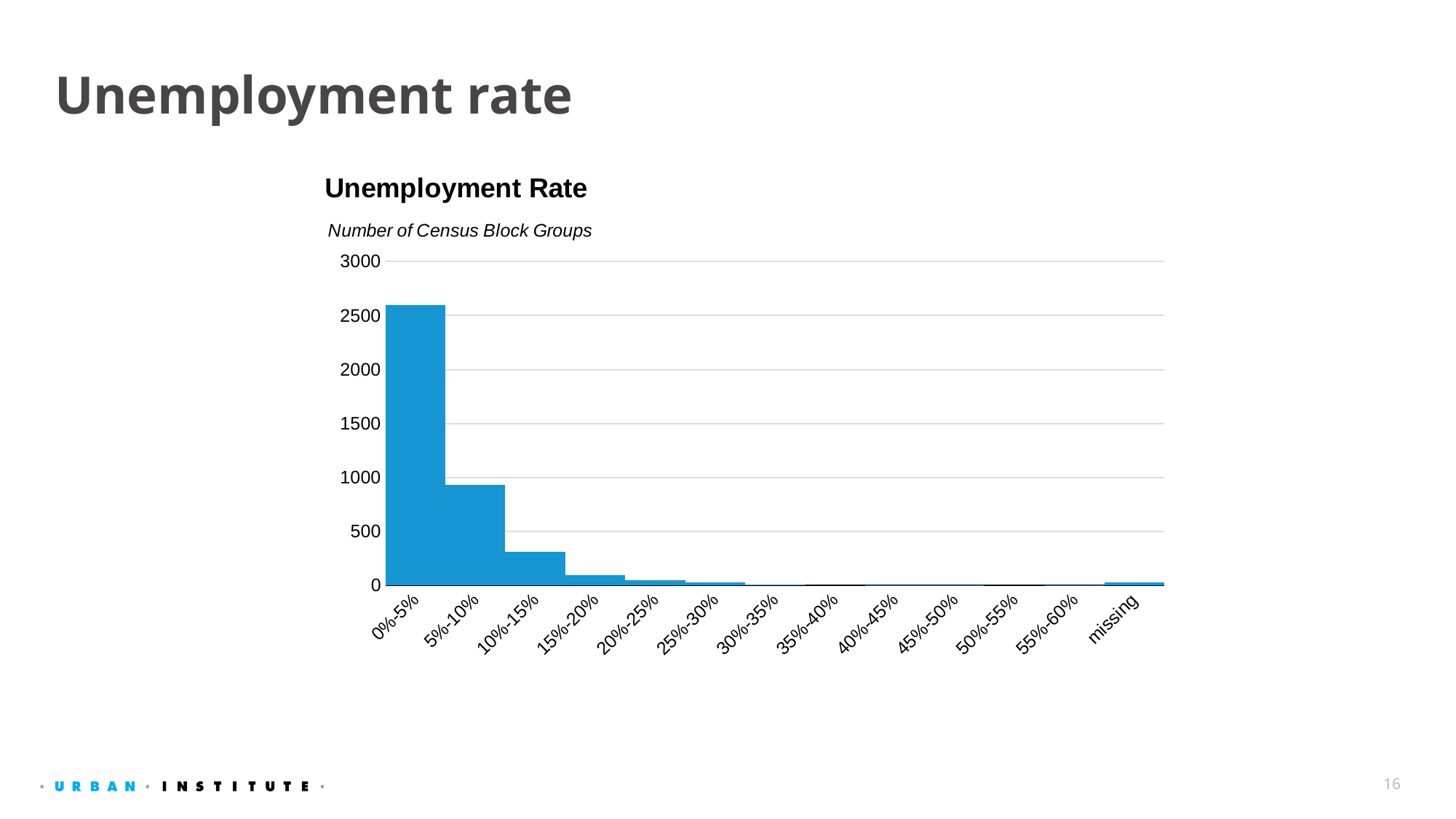
Which category has the highest number of census block groups? 0%-5% Is the value for 5%-10% greater or less than 1000? less Do the values rise or fall moving from 0%-5% to 25%-30% along the x axis? fall What does the vertical axis of the chart measure? Number of Census Block Groups What type of chart is shown on the slide? bar chart What is the title of the chart? Unemployment Rate Which is larger, the value for 5%-10% or the value for 10%-15%? 5%-10% How many categories are shown on the x axis? 13 Is the value for 15%-20% greater or less than 500? less Is the value for 0%-5% greater or less than 2500? greater Which is larger, the value for 0%-5% or the value for 5%-10%? 0%-5%